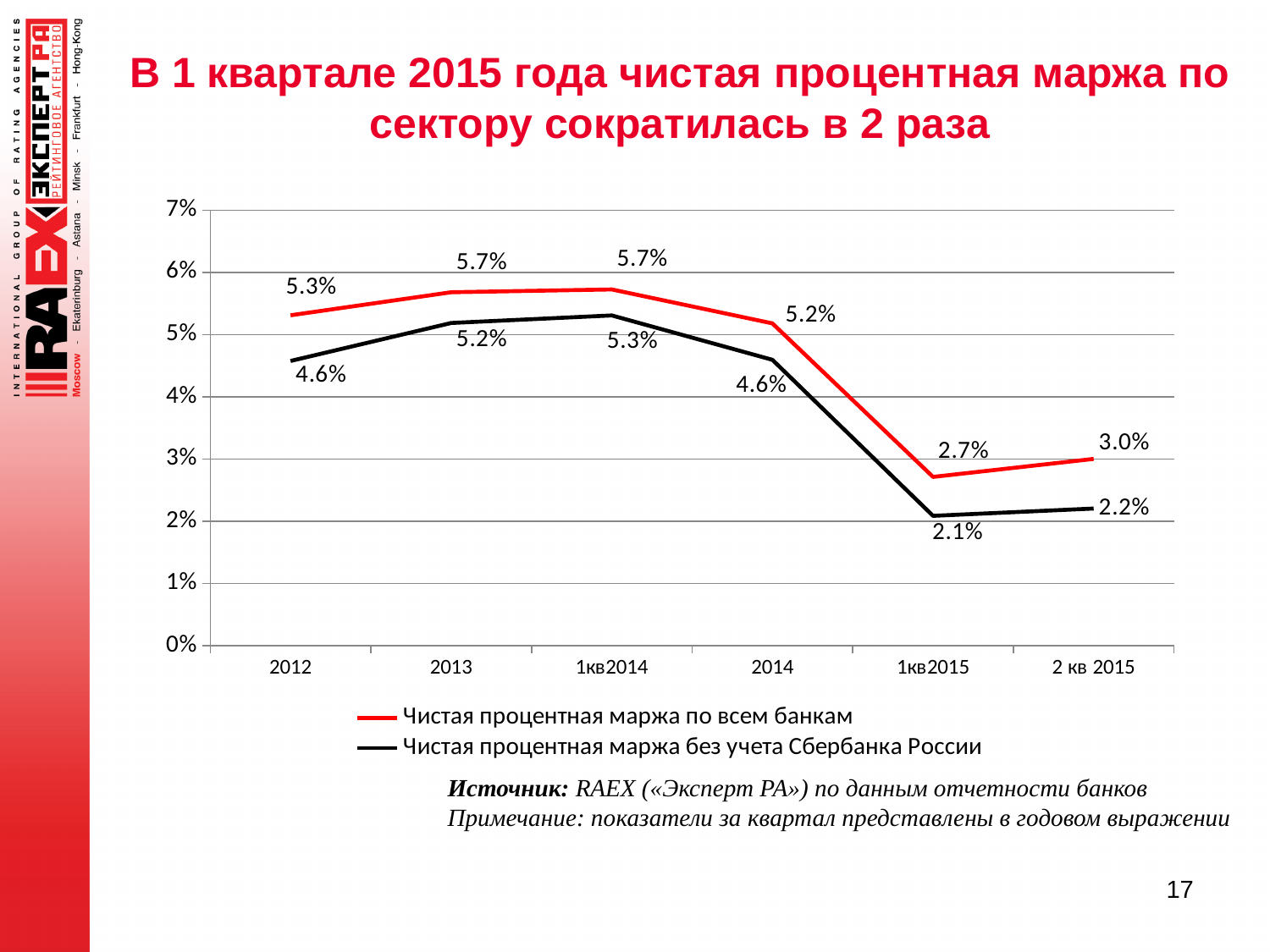
What type of chart is shown on the slide? line chart What is the value of 'Чистая процентная маржа без учета Сбербанка России' for 1кв2015? 2.1% In which category is 'Чистая процентная маржа без учета Сбербанка России' lowest? 1кв2015 How many series does the legend list? 2 What is the value of 'Чистая процентная маржа по всем банкам' for 2012? 5.3% How many categories are shown on the x axis? 6 Does 'Чистая процентная маржа по всем банкам' rise or fall between 2014 and 1кв2015? fall Which series has the larger value in 2013: 'Чистая процентная маржа по всем банкам' or 'Чистая процентная маржа без учета Сбербанка России'? Чистая процентная маржа по всем банкам What colour is the line for 'Чистая процентная маржа без учета Сбербанка России'? black In which category is 'Чистая процентная маржа без учета Сбербанка России' highest? 1кв2014 What is the difference between 'Чистая процентная маржа по всем банкам' and 'Чистая процентная маржа без учета Сбербанка России' in 2014? 0.6% What is the value of 'Чистая процентная маржа по всем банкам' for 2 кв 2015? 3.0%